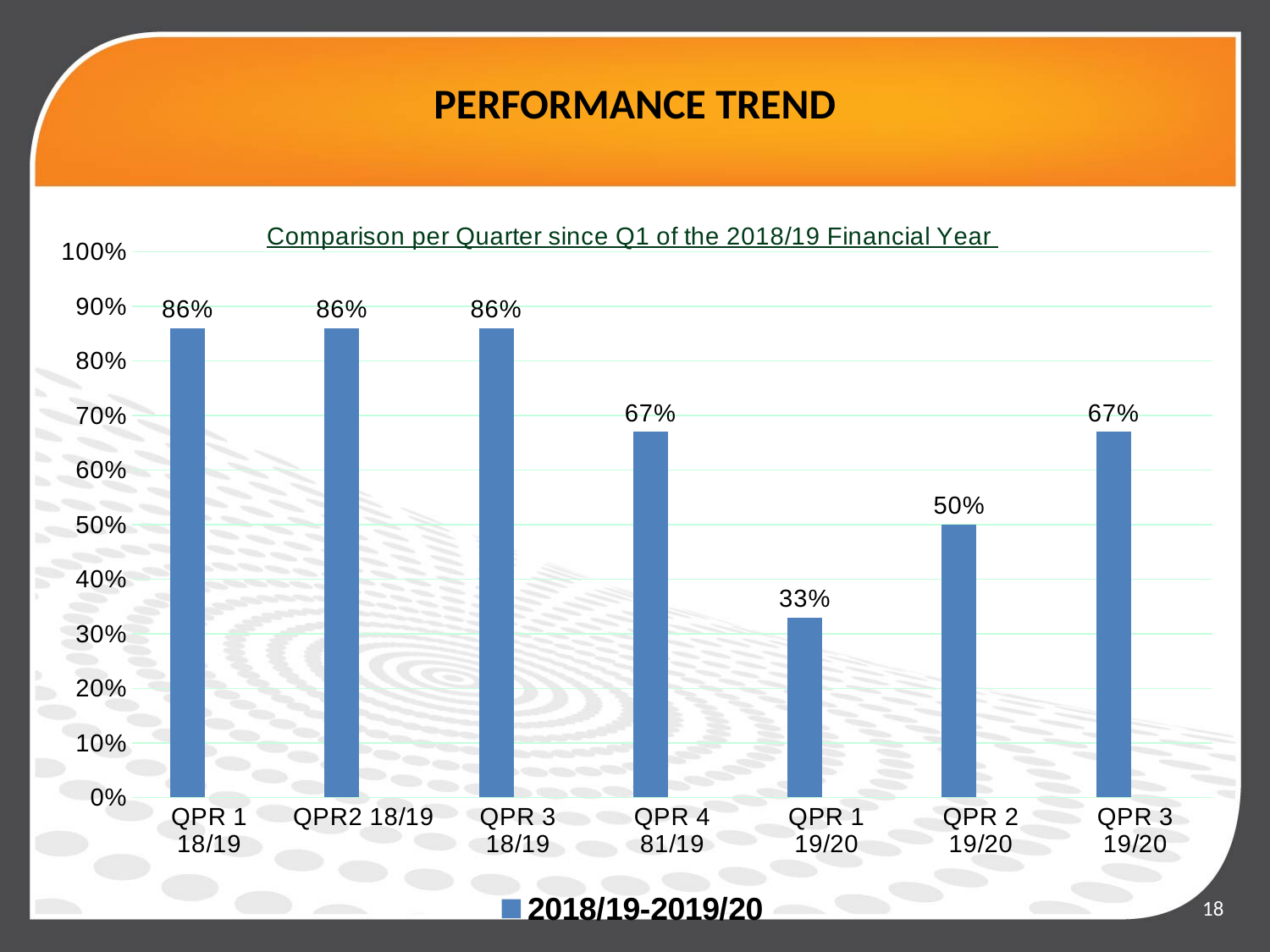
What kind of chart is shown? bar chart How many quarters are shown on the x axis? 7 What is the value for QPR 2 19/20? 50% What is the difference between the values for QPR 3 19/20 and QPR 2 19/20? 17% Do the values rise or fall from QPR 1 19/20 to QPR 3 19/20? rise What is the title of the chart? Comparison per Quarter since Q1 of the 2018/19 Financial Year What is the value for QPR 1 19/20? 33% Which quarter has the lowest value? QPR 1 19/20 Which is larger, the value for QPR 2 19/20 or the value for QPR 4 81/19? QPR 4 81/19 What is the value for QPR 4 81/19? 67% How many series does the legend list? 1 What is the difference between the values for QPR 3 18/19 and QPR 1 19/20? 53%